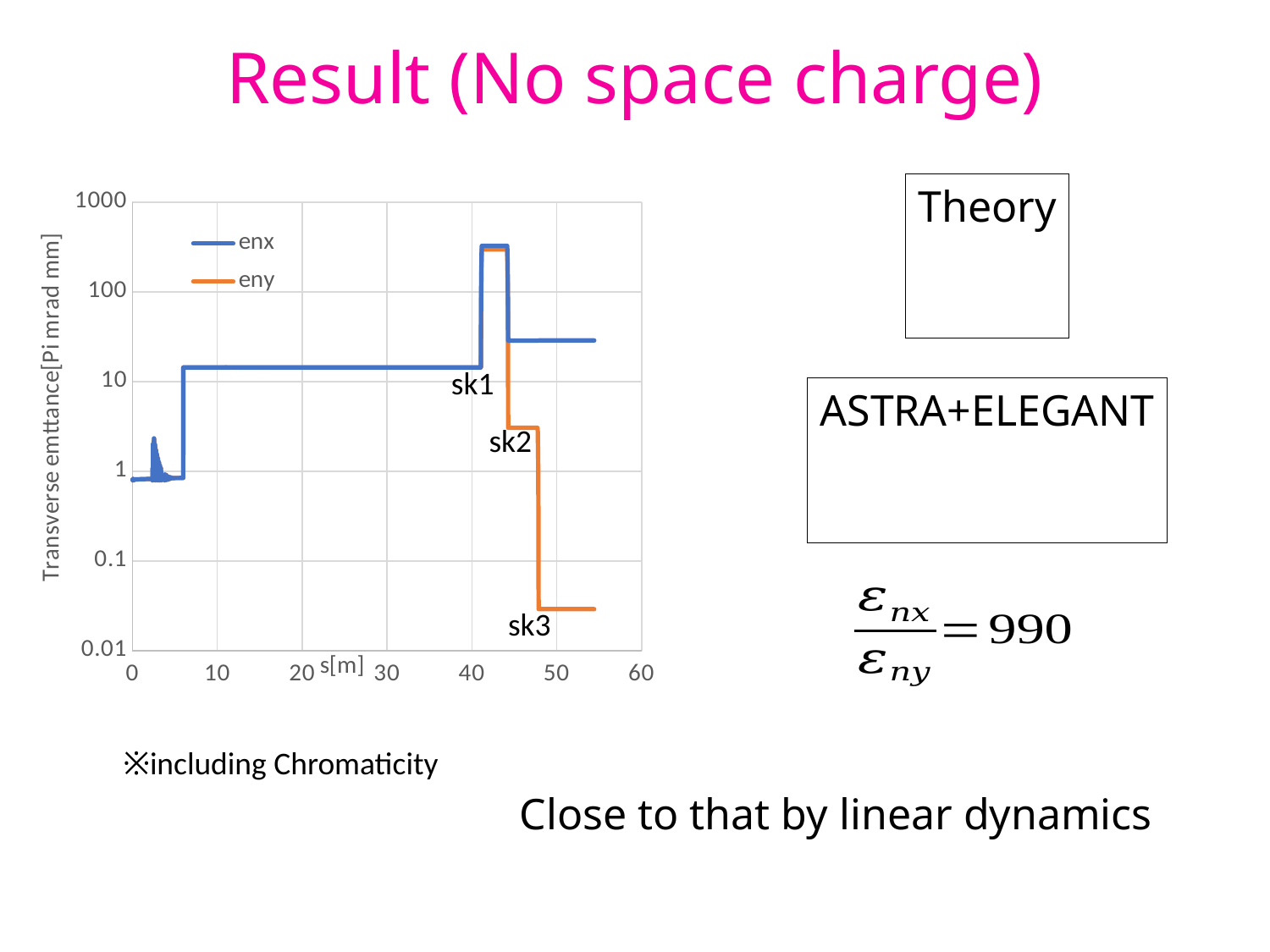
Is the value of enx at s = 30 m greater or less than 10? greater Is the value of eny at s = 50 m greater or less than 0.1? less What kind of chart is shown on the slide? line chart At s = 50 m, which series has the larger value, enx or eny? enx Is the value of enx at s = 42 m greater or less than 100? greater Does the eny series rise or fall between s = 45 m and s = 50 m? fall What are the two series named in the chart legend? enx and eny What is the label of the chart's vertical axis? Transverse emttance[Pi mrad mm] Does the enx series rise or fall between s = 5 m and s = 10 m? rise How many series does the chart legend list? 2